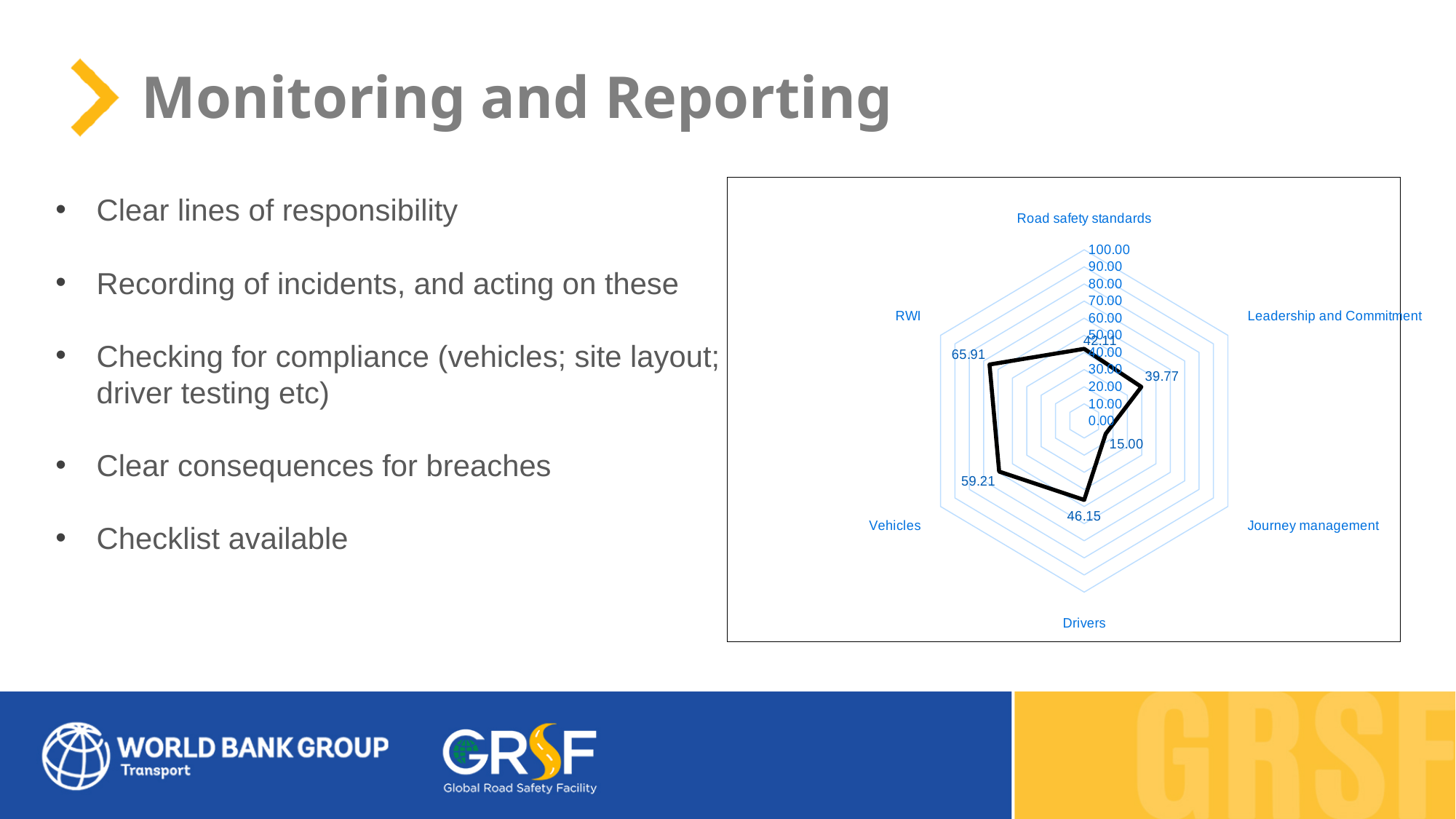
Which category has the lowest value? Journey management What is the maximum value shown on the radar chart's axis scale? 100.00 Which category has the highest value? RWI What is the value for Leadership and Commitment? 39.77 Which is larger, the value for Drivers or the value for Road safety standards? Drivers What kind of chart is shown on the slide? radar chart What is the value for RWI? 65.91 What is the value for Journey management? 15.00 How many categories (axes) does the radar chart have? 6 What is the difference between the values for RWI and Vehicles? 6.70 What is the value for Drivers? 46.15 Is the value for Vehicles greater or less than 50.00? greater